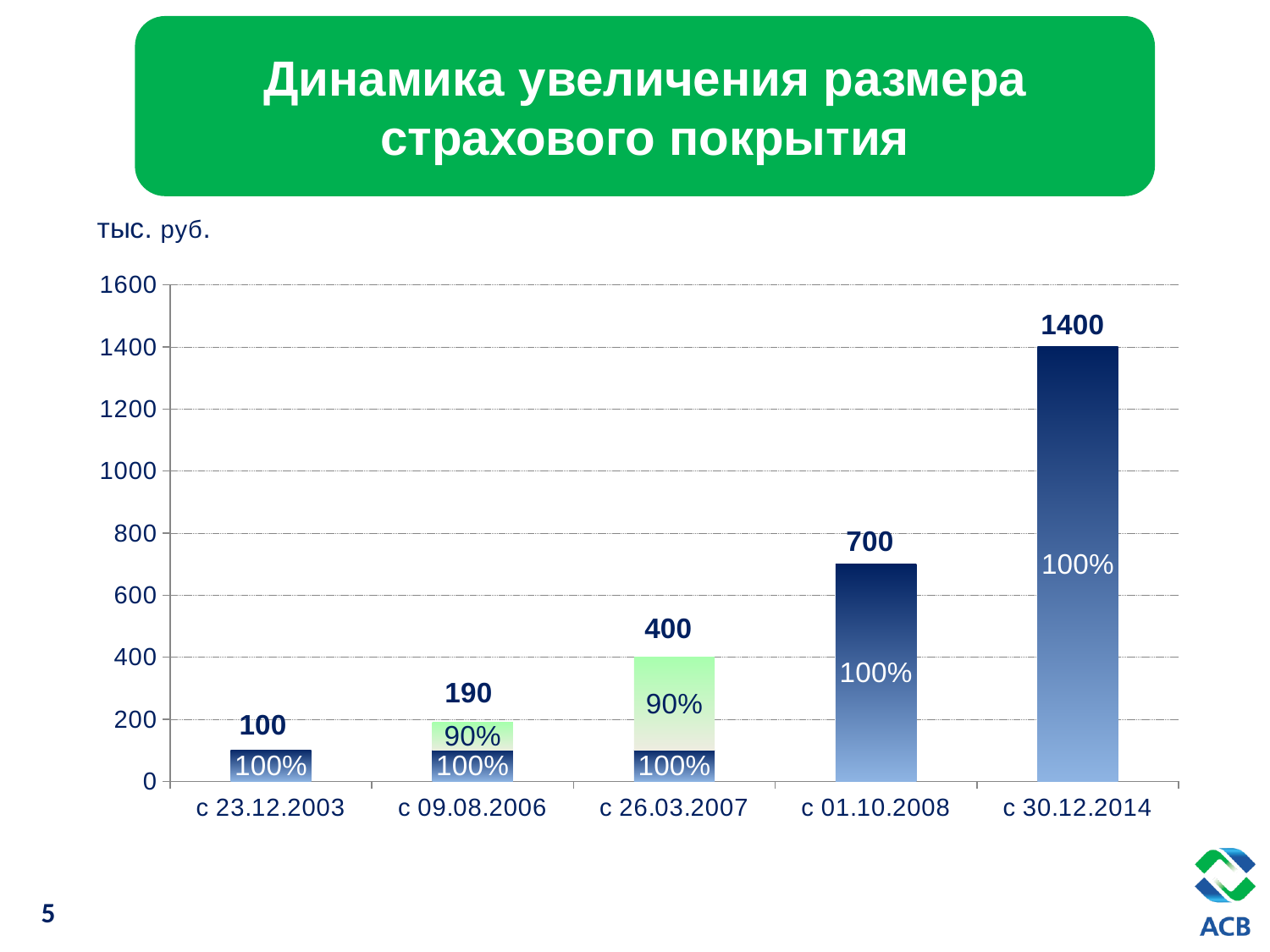
How many periods (bars) are shown on the chart? 5 Which is larger, the total for с 01.10.2008 or the total for с 26.03.2007? с 01.10.2008 What is the total value shown for с 26.03.2007? 400 Which period has the lowest total value? с 23.12.2003 What kind of chart is shown on the slide? Bar chart What is the difference between the totals for с 26.03.2007 and с 09.08.2006? 210 What unit is indicated above the chart's vertical axis? тыс. руб. What is the total value shown for с 09.08.2006? 190 Do the total values rise or fall from left to right along the x axis? Rise Which period has the highest total value? с 30.12.2014 What is the difference between the totals for с 30.12.2014 and с 01.10.2008? 700 What is the total insurance coverage shown for с 30.12.2014? 1400